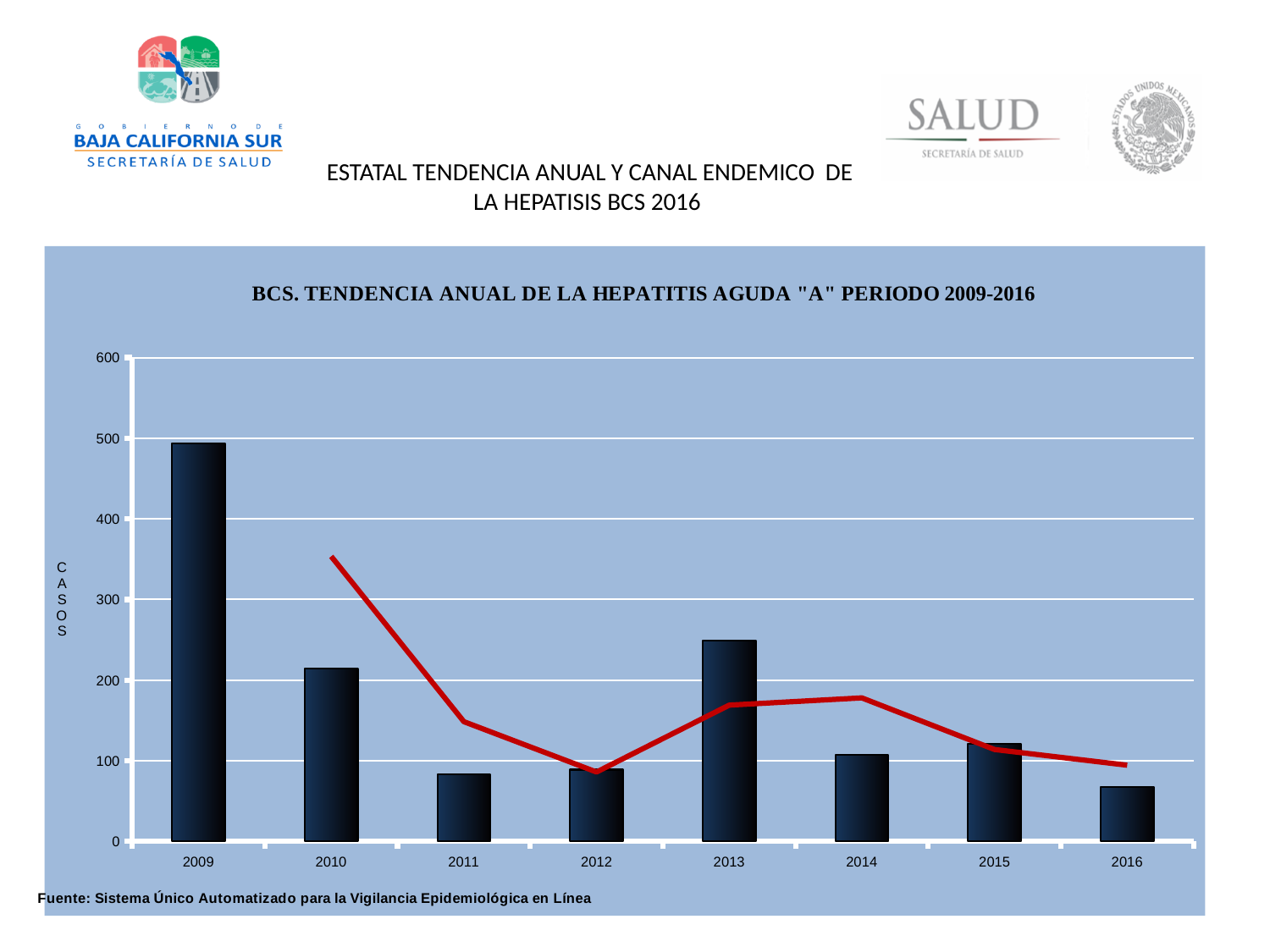
What label is shown on the vertical axis of the chart? CASOS Is the bar value for 2009 greater or less than 400? greater Is the bar value for 2013 greater or less than 300? less What kind of chart is shown on the slide? Bar chart with a line overlay Is the bar value for 2011 greater or less than 100? less Which year has a taller bar, 2010 or 2013? 2013 Which year has the lowest bar in the chart? 2016 How many years are shown on the x axis of the chart? 8 Do the bar values rise or fall from 2009 to 2012? fall Which year has the highest bar in the chart? 2009 What is the title of the chart? BCS. TENDENCIA ANUAL DE LA HEPATITIS AGUDA "A" PERIODO 2009-2016